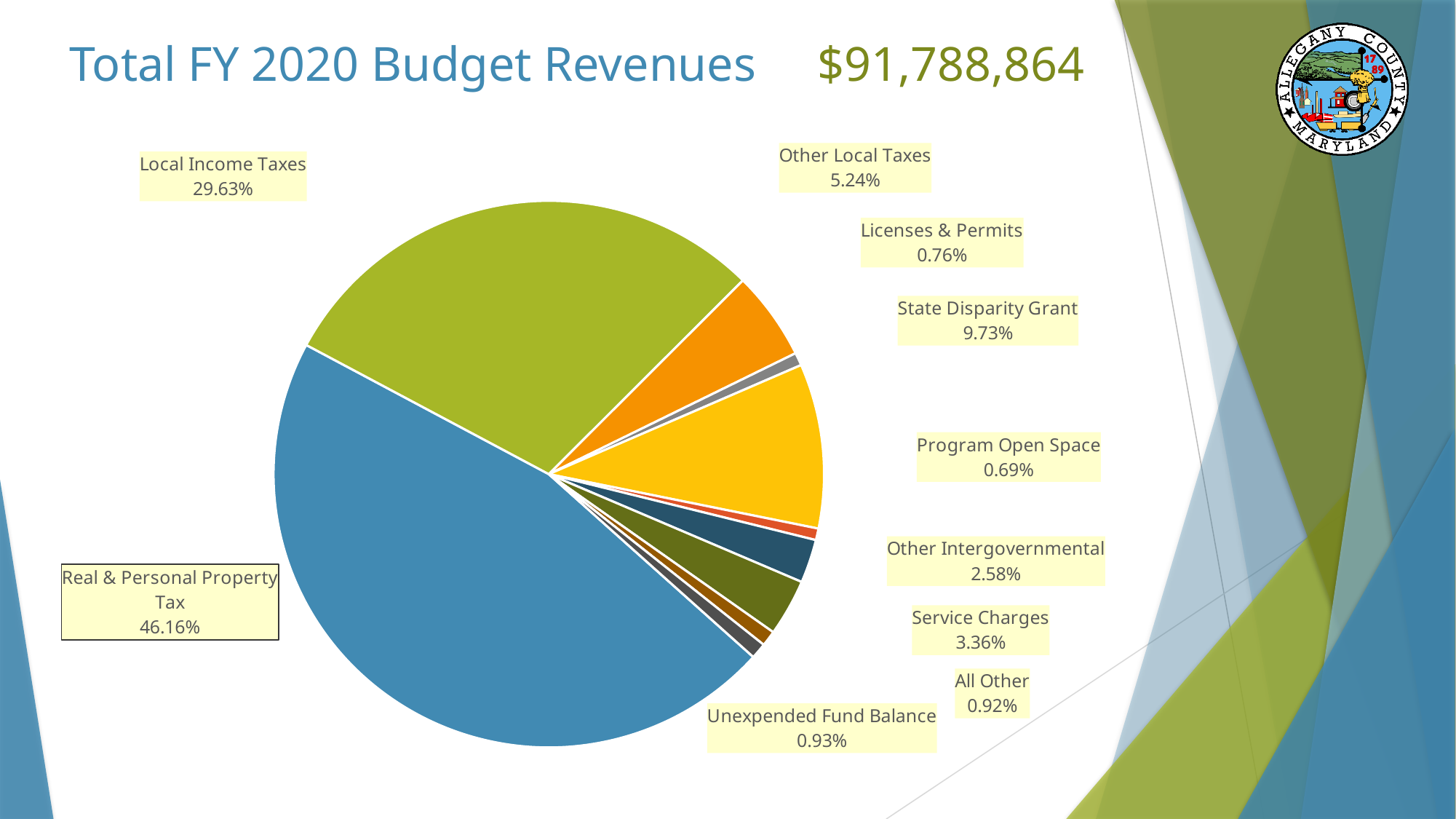
What total revenue amount is shown in the slide title? $91,788,864 What kind of chart is shown on the slide? pie chart How many revenue categories are labelled on the pie chart? 10 What share of revenues comes from Real & Personal Property Tax? 46.16% Which revenue category has the largest share of the pie? Real & Personal Property Tax What is the difference in percentage points between Real & Personal Property Tax and Local Income Taxes? 16.53 What percentage is shown for Service Charges? 3.36% Which revenue category has the smallest share of the pie? Program Open Space What share of revenues comes from Local Income Taxes? 29.63% Which is larger, Other Local Taxes or Other Intergovernmental? Other Local Taxes What percentage is shown for the State Disparity Grant? 9.73% What is the combined share of Licenses & Permits and Program Open Space? 1.45%